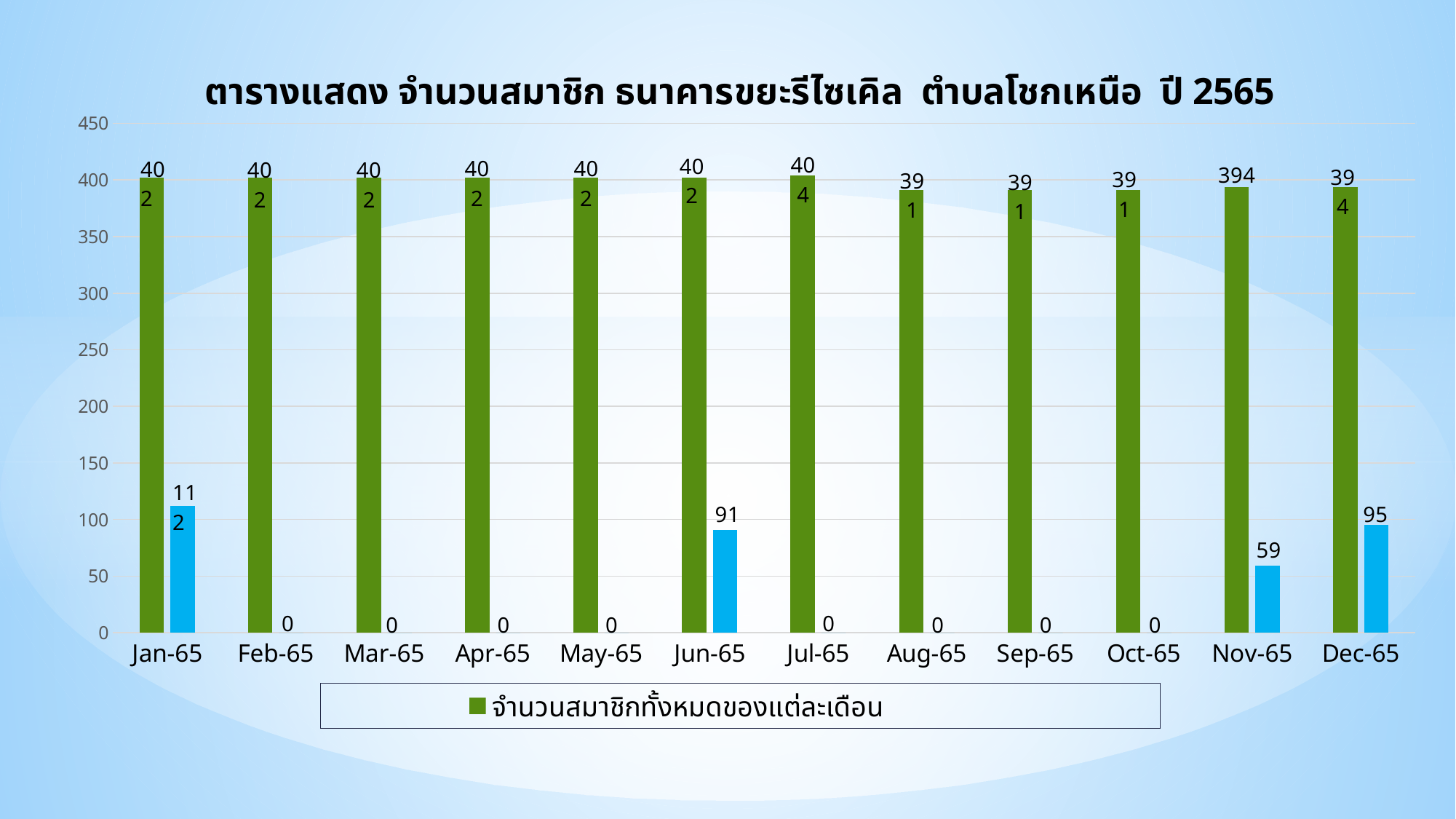
How many months are shown on the x axis? 12 What kind of chart is shown on the slide? Bar chart Which has the larger blue bar, Nov-65 or Dec-65? Dec-65 Which month has the highest green bar? Jul-65 What is the value of the green bar for Jul-65? 404 What is the difference between the blue bar values for Jan-65 and Dec-65? 17 What is the value of the blue bar for Jun-65? 91 What is the value of the green bar for Nov-65? 394 Is the green bar value for Aug-65 greater or less than 350? greater How many months have a blue bar value of 0? 8 How many series does the legend list? 1 Which month has the highest blue bar? Jan-65